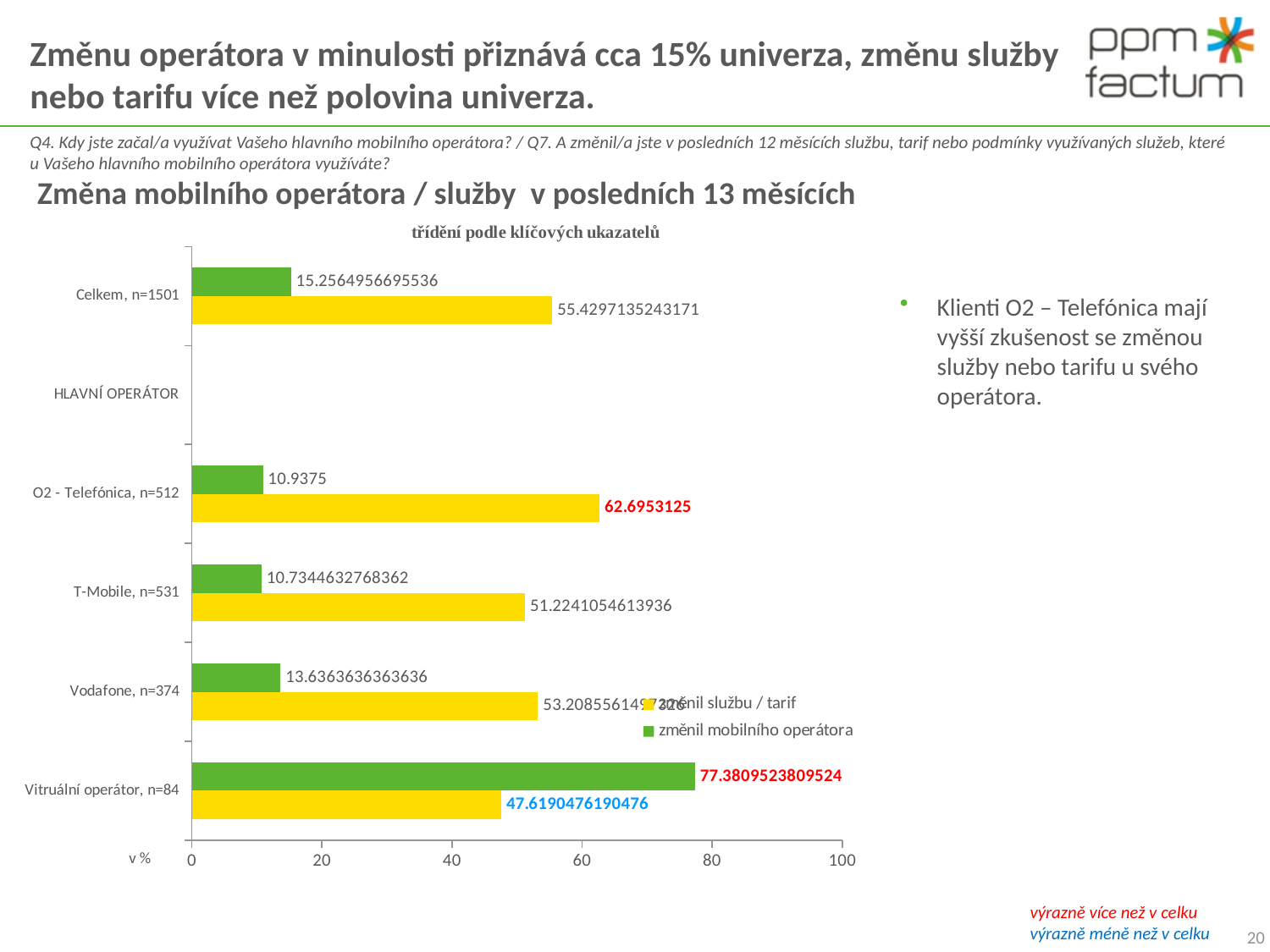
What is the value for 'změnil službu / tarif' for O2 - Telefónica, n=512? 62.6953125 What is the value for 'změnil mobilního operátora' for Vitruální operátor, n=84? 77.3809523809524 What is the value for 'změnil službu / tarif' for T-Mobile, n=531? 51.2241054613936 How many series does the legend list? 2 Is the value for 'změnil službu / tarif' for Vodafone, n=374 greater or less than 40? greater What is the value for 'změnil mobilního operátora' for O2 - Telefónica, n=512? 10.9375 For Vitruální operátor, n=84, which is larger: 'změnil službu / tarif' or 'změnil mobilního operátora'? změnil mobilního operátora Which category has the highest value for 'změnil mobilního operátora'? Vitruální operátor, n=84 Which category has the lowest value for 'změnil službu / tarif'? Vitruální operátor, n=84 Which category has the highest value for 'změnil službu / tarif'? O2 - Telefónica, n=512 What is the difference between 'změnil mobilního operátora' and 'změnil službu / tarif' for Vitruální operátor, n=84? 29.7619047619048 What is the value for 'změnil mobilního operátora' for Celkem, n=1501? 15.2564956695536